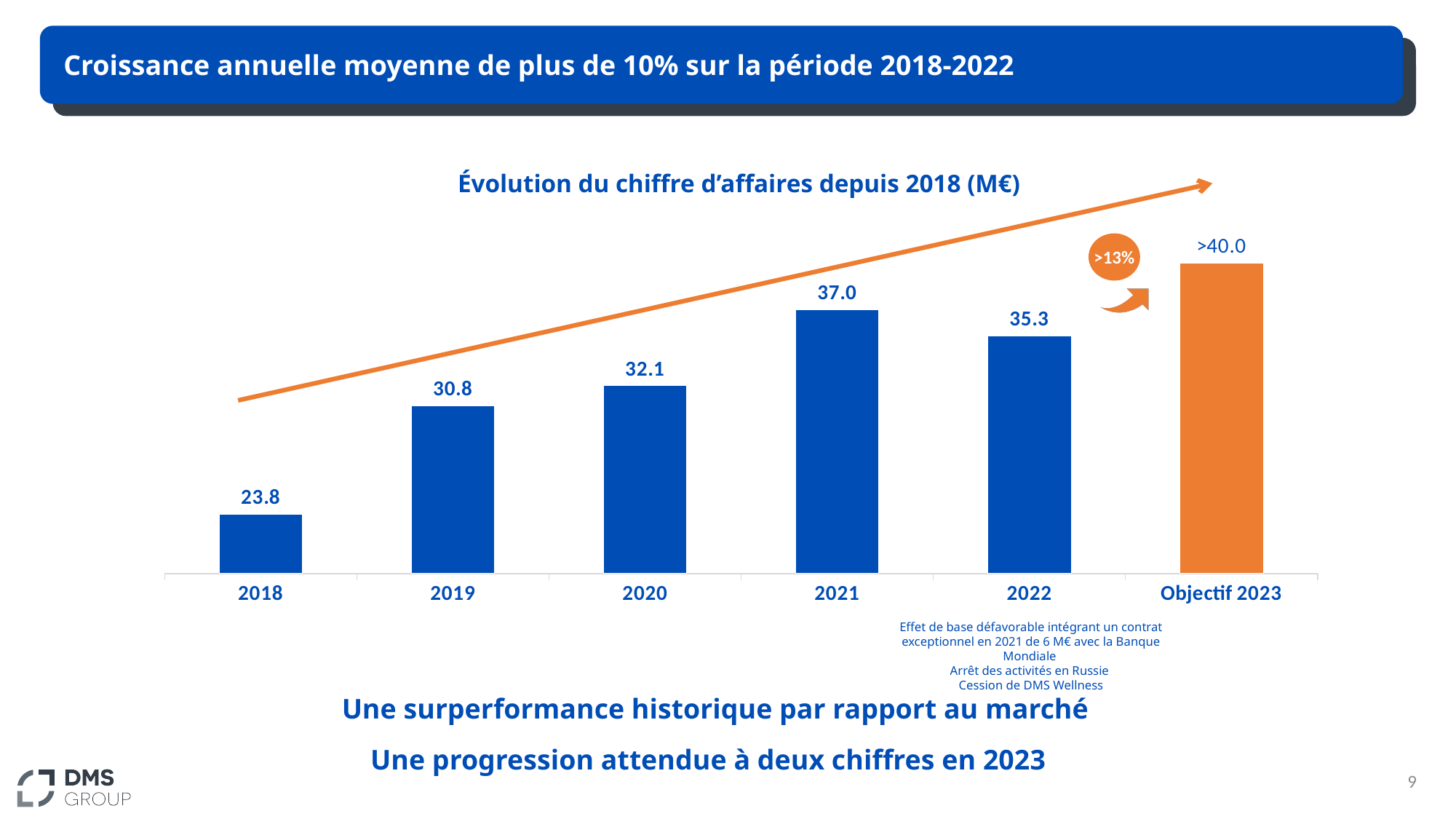
What is the value for 2022? 35.3 What is the title of the chart? Évolution du chiffre d'affaires depuis 2018 (M€) What is the difference between the values for 2021 and 2022? 1.7 What is the value for 2021? 37.0 Which category has the lowest value? 2018 How many categories are shown on the x axis? 6 What is the value for 2018? 23.8 What is the difference between the values for 2019 and 2018? 7.0 What is the value shown for Objectif 2023? >40.0 Which year between 2018 and 2022 has the highest value? 2021 What kind of chart is this? Bar chart Which is larger, the value for 2020 or the value for 2019? 2020